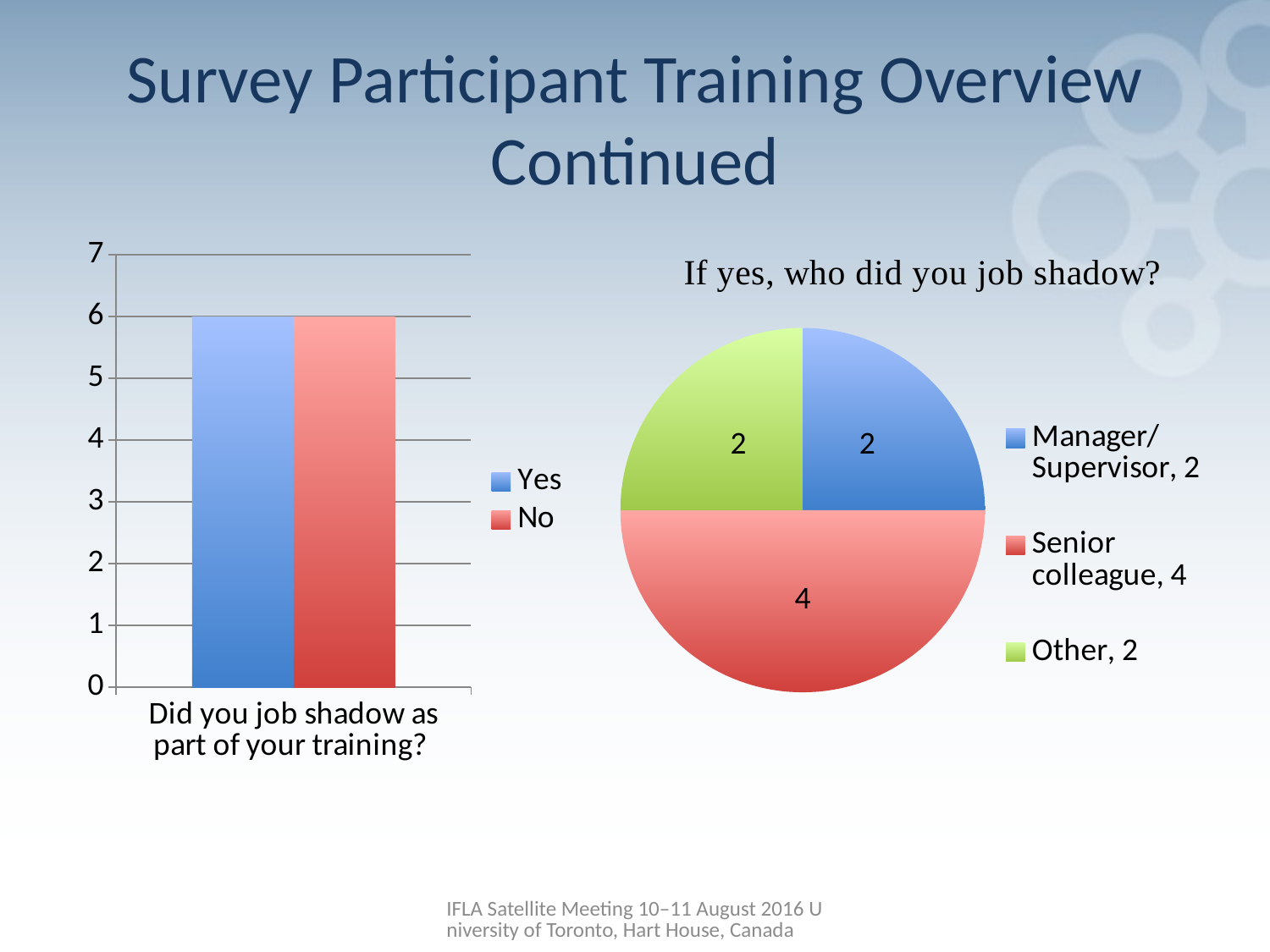
In the bar chart on the left, what is the value for No? 6 How many series does the legend of the bar chart on the left list? 2 In the chart 'If yes, who did you job shadow?', what is the value for Senior colleague? 4 How many categories are shown in the chart 'If yes, who did you job shadow?'? 3 In the bar chart on the left, what is the value for Yes? 6 In the chart 'If yes, who did you job shadow?', which category has the highest value? Senior colleague In the chart 'If yes, who did you job shadow?', what share of the pie does Senior colleague represent? 50% In the chart 'If yes, who did you job shadow?', what is the value for Manager/Supervisor? 2 In the bar chart on the left, is the value for No greater or less than 5? greater What kind of chart is the chart on the left of the slide? bar chart What kind of chart is 'If yes, who did you job shadow?'? pie chart In the chart 'If yes, who did you job shadow?', what is the difference between Senior colleague and Other? 2